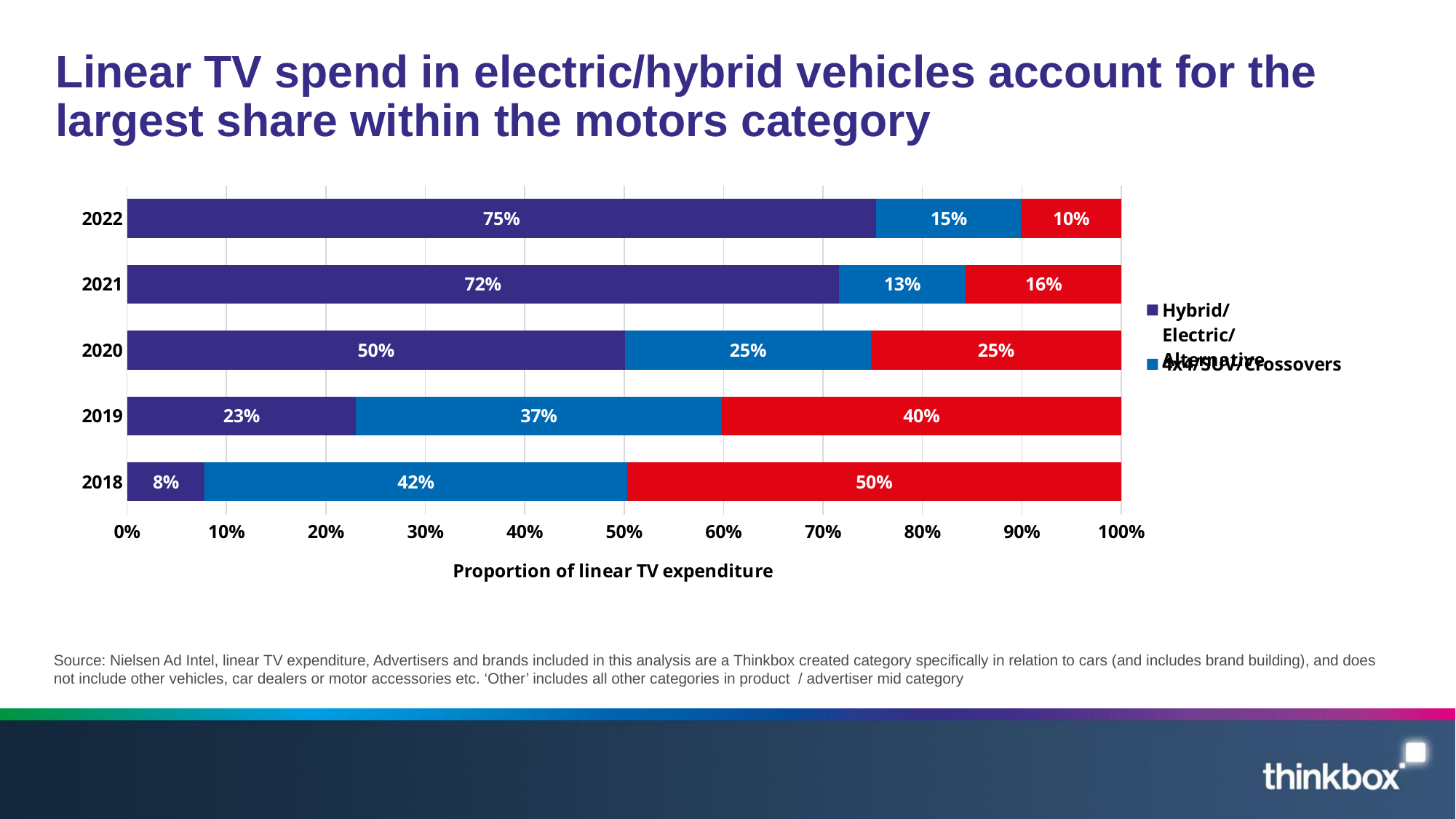
What is the 4x4/SUV/Crossovers share of linear TV expenditure in 2018? 42% What is the difference between the 4x4/SUV/Crossovers share in 2019 and in 2022? 22 percentage points Which is larger in 2021: the 4x4/SUV/Crossovers share or the red segment? The red segment (16%) What is the label of the horizontal axis? Proportion of linear TV expenditure What is the value of the red segment for 2019? 40% In which year is the Hybrid/Electric/Alternative share the highest? 2022 What is the Hybrid/Electric/Alternative share of linear TV expenditure in 2022? 75% In which year is the Hybrid/Electric/Alternative share the lowest? 2018 How many years are shown on the chart? 5 By how many percentage points did the Hybrid/Electric/Alternative share change from 2018 to 2022? 67 percentage points Does the Hybrid/Electric/Alternative share rise or fall from 2018 to 2022? Rise What type of chart is shown on the slide? Stacked bar chart